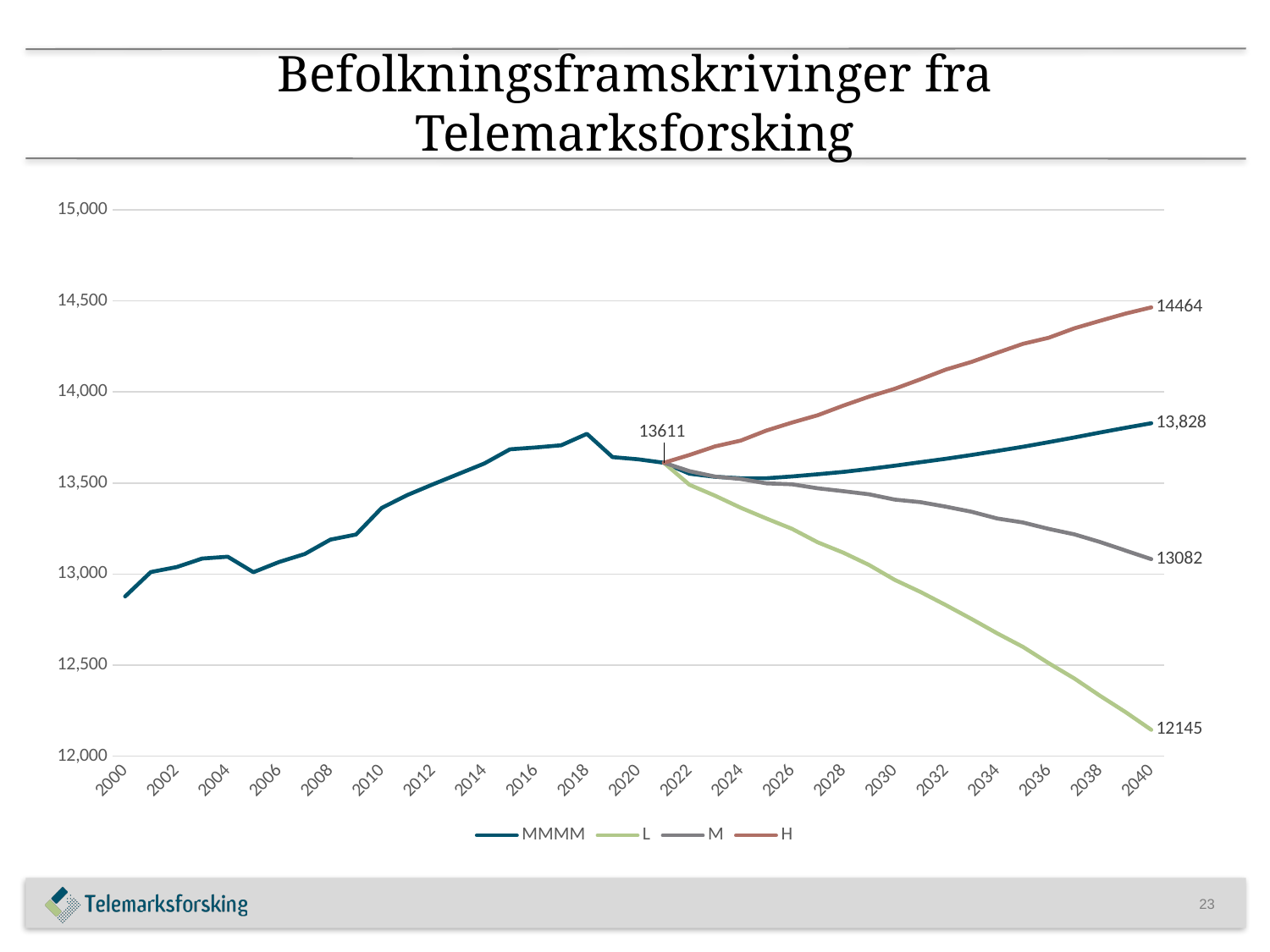
What kind of chart is shown on the slide? line chart What is the value of the MMMM series in 2040? 13,828 How many series does the legend list? 4 What is the value of the L series in 2040? 12145 Which series has the lowest value in 2040? L Is the value of the MMMM series in 2000 greater or less than 13,000? less Which series has the highest value in 2040? H What is the value of the H series in 2040? 14464 What value is labelled at the point where the projection lines diverge around 2021? 13611 What is the value of the M series in 2040? 13082 What is the difference between the H and L values in 2040? 2319 In 2040, which is larger: the M series or the L series? M